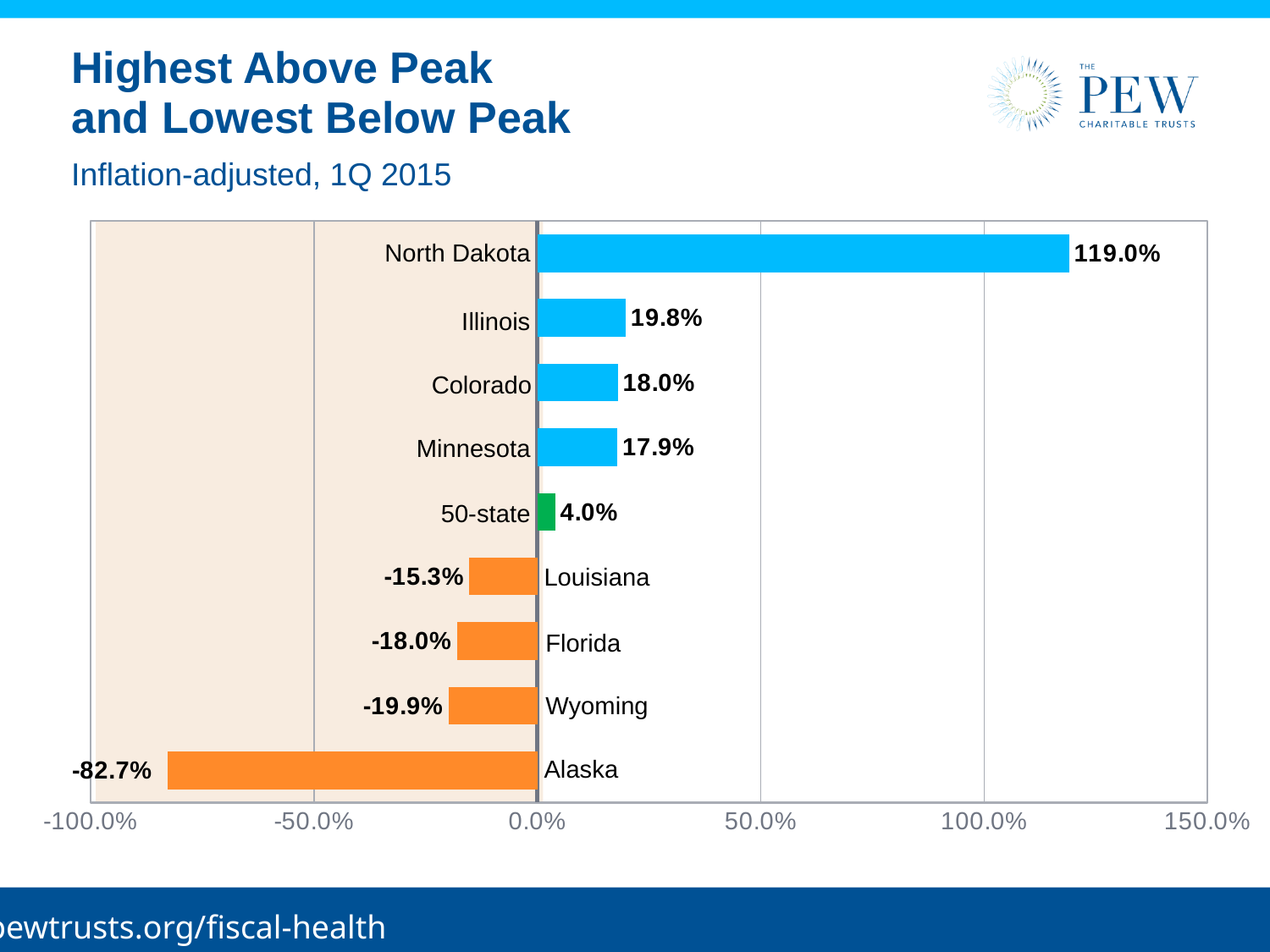
Which is larger, the value for Minnesota or the value for Colorado? Colorado What is the difference between the values for Illinois and Colorado? 1.8% What kind of chart is shown on the slide? bar chart What is the subtitle shown below the chart title? Inflation-adjusted, 1Q 2015 Is the value for North Dakota greater or less than 100.0%? greater What is the value for North Dakota? 119.0% What is the value for the 50-state bar? 4.0% How many categories are shown in the chart? 9 What is the value for Louisiana? -15.3% What is the value for Alaska? -82.7% Which category has the lowest value? Alaska Which category has the highest value? North Dakota